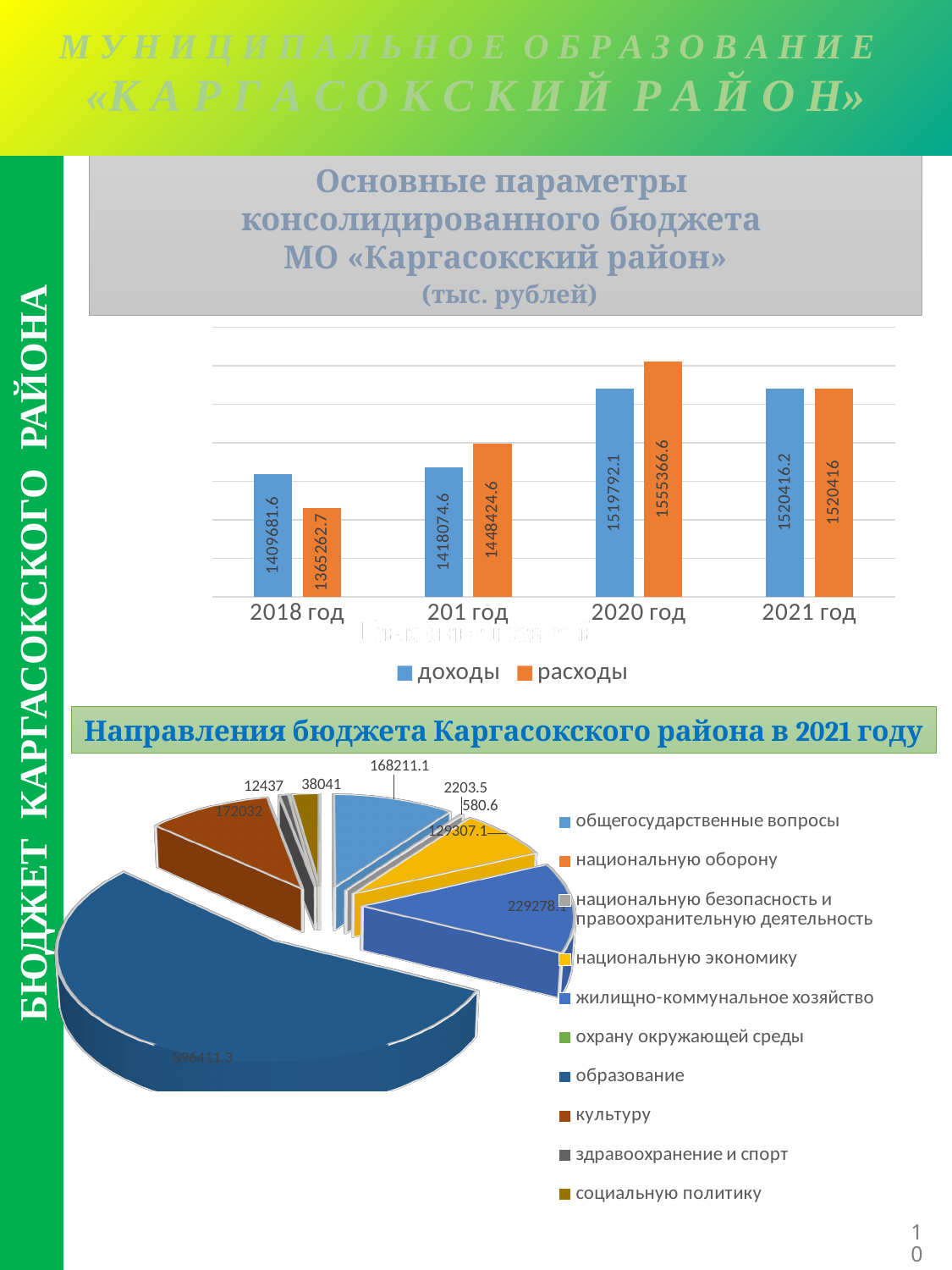
How many series does the legend of the top bar chart list? 2 What kind of chart is the top chart on the slide? bar chart In the pie chart 'Направления бюджета Каргасокского района в 2021 году', which category has the largest slice? образование In the pie chart 'Направления бюджета Каргасокского района в 2021 году', what is the value for образование? 896411.3 In the top bar chart, do the доходы values rise or fall from 2018 год to 2021 год? rise In the top bar chart, which is larger for 2020 год: доходы or расходы? расходы In the top bar chart, what is the difference between доходы and расходы for 2018 год? 44418.9 In the top bar chart, which year has the highest расходы? 2020 год In the top bar chart, which year has the lowest доходы? 2018 год In the top bar chart, what is the value of расходы for 2020 год? 1555366.6 In the top bar chart, what is the value of доходы for 2018 год? 1409681.6 How many categories does the legend of the pie chart 'Направления бюджета Каргасокского района в 2021 году' list? 10